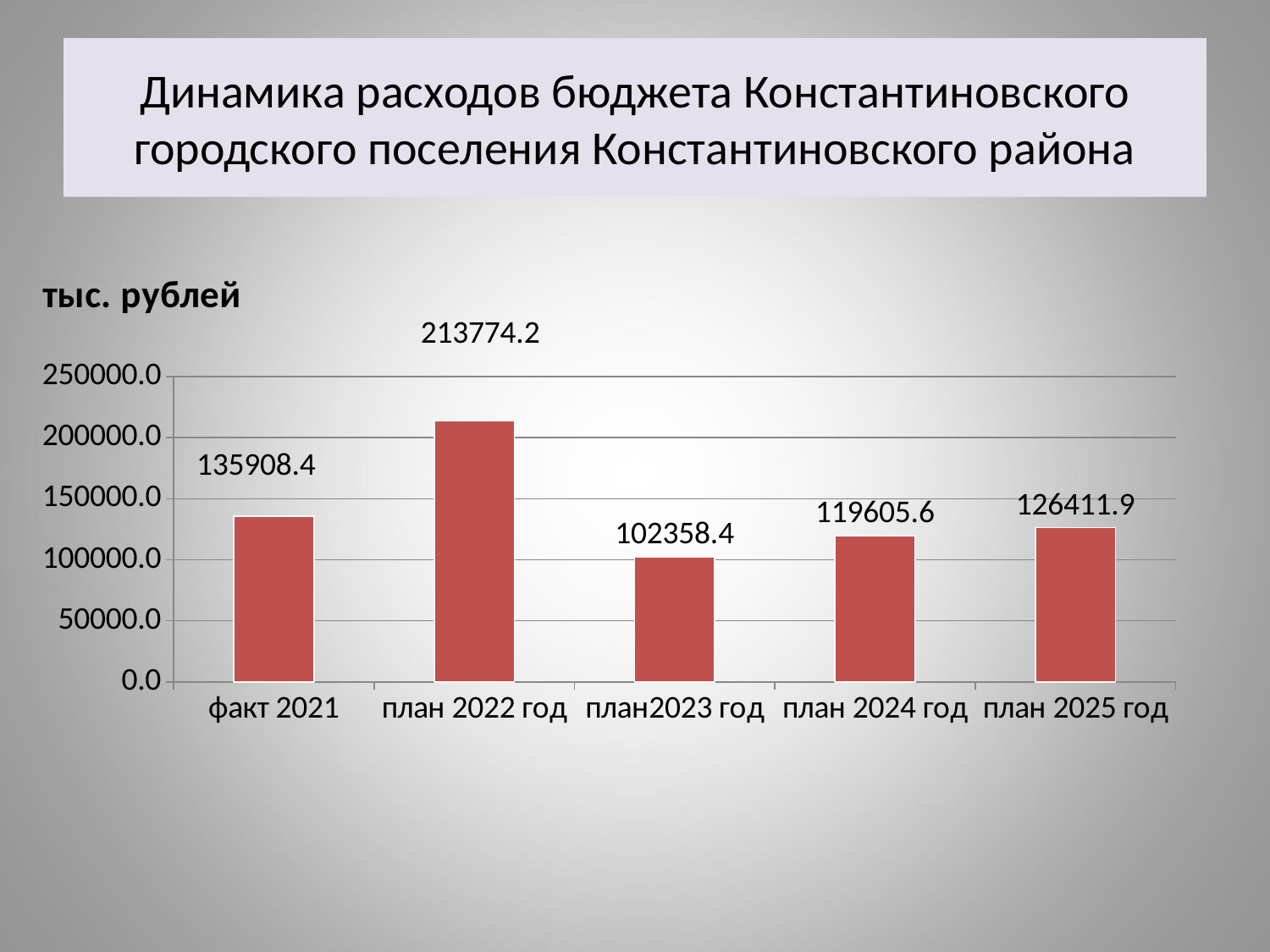
What kind of chart is shown on the slide? bar chart What is the value for план 2025 год? 126411.9 Which category has the highest value? план 2022 год Which category has the lowest value? план2023 год What is the difference between the values for план 2025 год and план 2024 год? 6806.3 Which is larger, the value for факт 2021 or the value for план 2024 год? факт 2021 What is the difference between the values for план 2022 год and факт 2021? 77865.8 How many categories are shown on the x axis? 5 Do the values rise or fall from план2023 год to план 2025 год? rise What is the value for план2023 год? 102358.4 What is the value for план 2022 год? 213774.2 What is the value for факт 2021? 135908.4